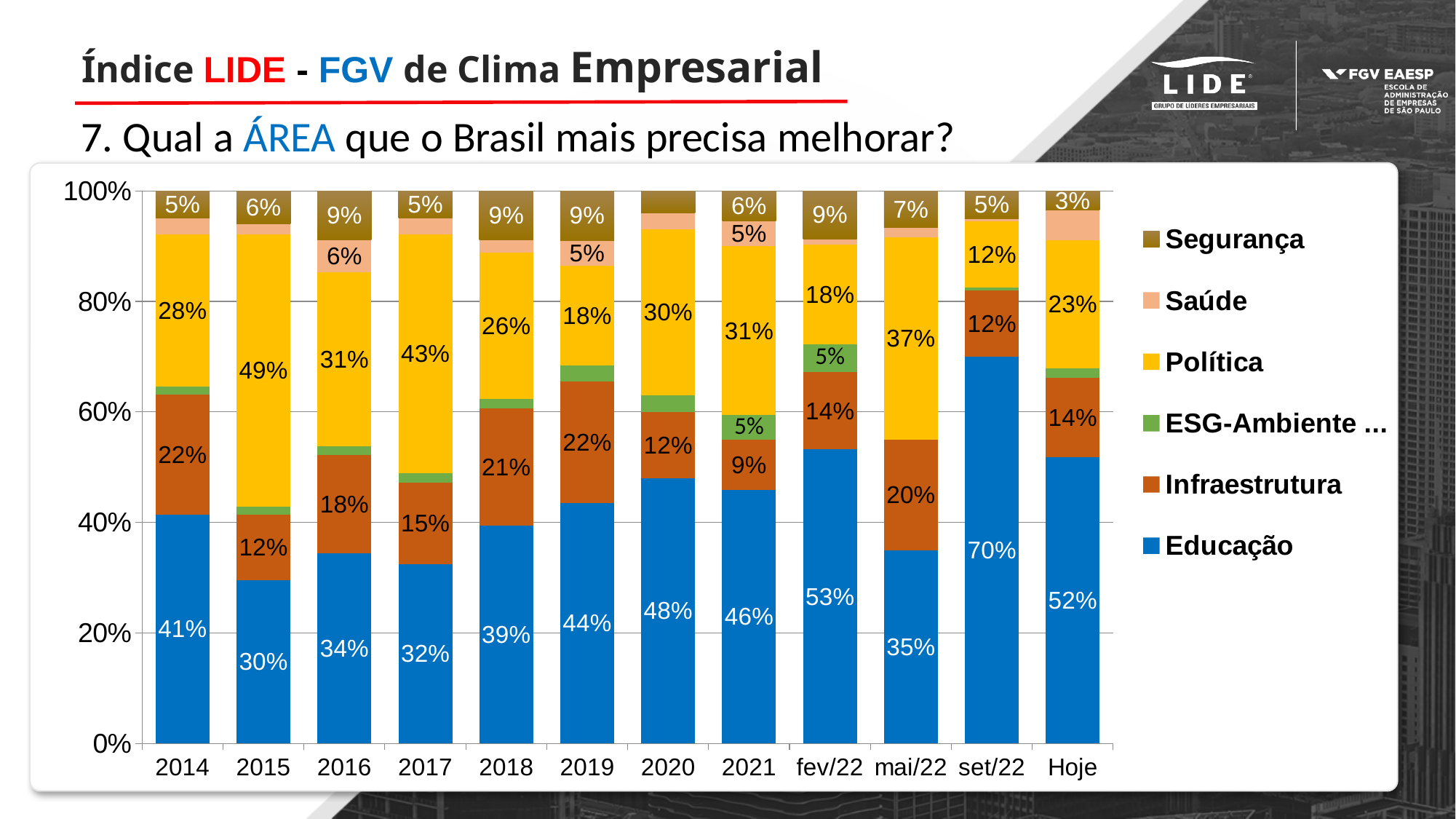
Which series is shown in blue in the legend? Educação Which is larger, the Política value in 2017 or in 2016? 2017 What is the value for Política in 2015? 49% How many series does the legend list? 6 What is the difference between the Educação value in set/22 and in Hoje? 18 percentage points How many categories are shown along the x axis? 12 What is the value for Infraestrutura in 2018? 21% What is the value for Educação in set/22? 70% What is the value for Segurança in Hoje? 3% What kind of chart is shown on the slide? Stacked bar chart In which category is Educação lowest? 2015 In which category is Educação highest? set/22